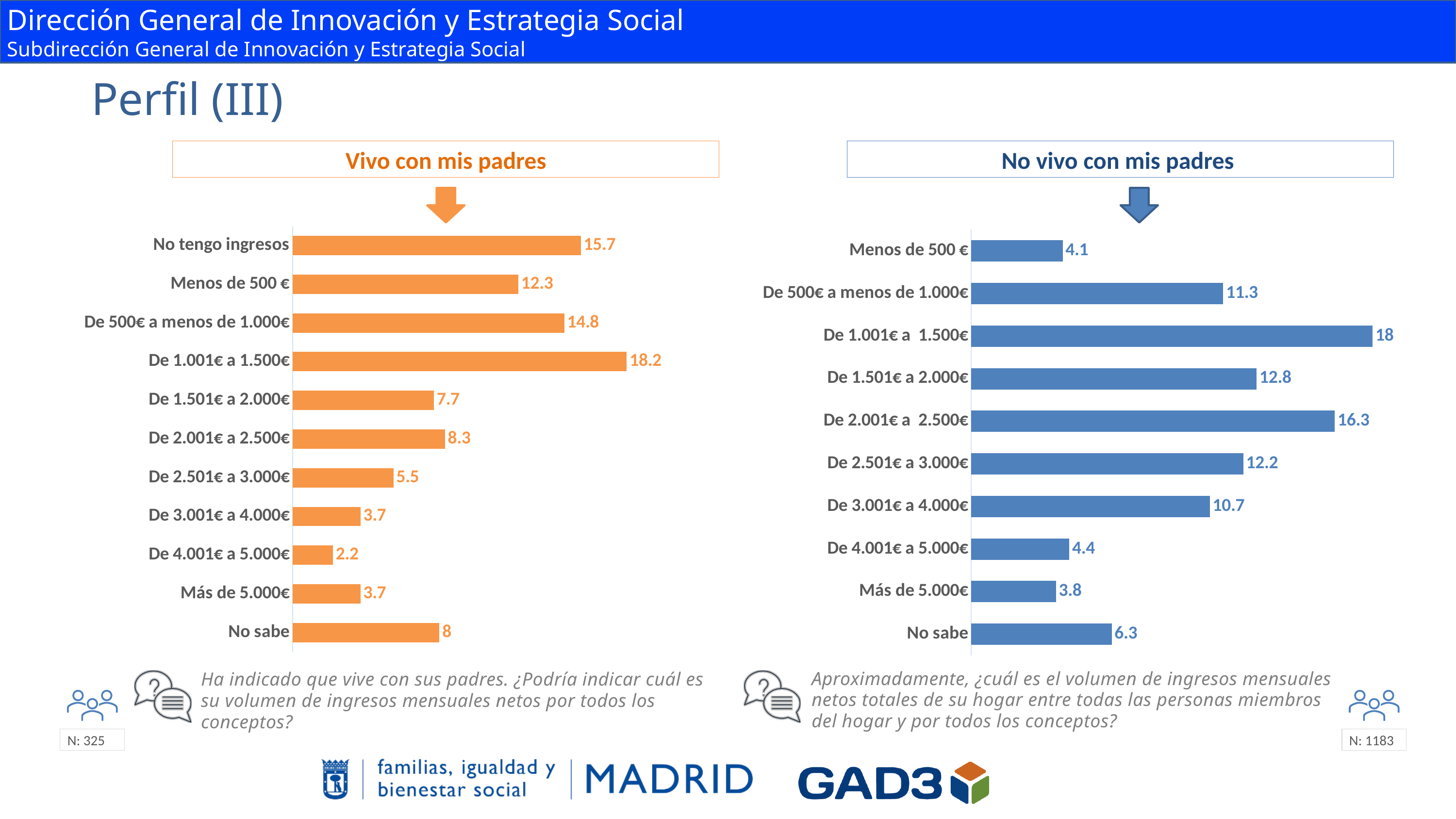
In the 'No vivo con mis padres' chart, which category has the highest value? De 1.001€ a 1.500€ What type of chart is the 'No vivo con mis padres' chart? Bar chart How many categories does the 'No vivo con mis padres' chart show? 10 In the 'Vivo con mis padres' chart, which category has the highest value? De 1.001€ a 1.500€ How many categories does the 'Vivo con mis padres' chart show? 11 In the 'No vivo con mis padres' chart, what is the value for 'De 2.001€ a 2.500€'? 16.3 In the 'No vivo con mis padres' chart, which category has the lowest value? Más de 5.000€ In the 'Vivo con mis padres' chart, what is the value for 'No tengo ingresos'? 15.7 In the 'Vivo con mis padres' chart, which category has the lowest value? De 4.001€ a 5.000€ In the 'Vivo con mis padres' chart, what is the difference between 'Menos de 500 €' and 'De 2.501€ a 3.000€'? 6.8 In the 'Vivo con mis padres' chart, which is larger: 'De 500€ a menos de 1.000€' or 'Menos de 500 €'? De 500€ a menos de 1.000€ In the 'No vivo con mis padres' chart, what is the difference between 'De 1.501€ a 2.000€' and 'De 4.001€ a 5.000€'? 8.4